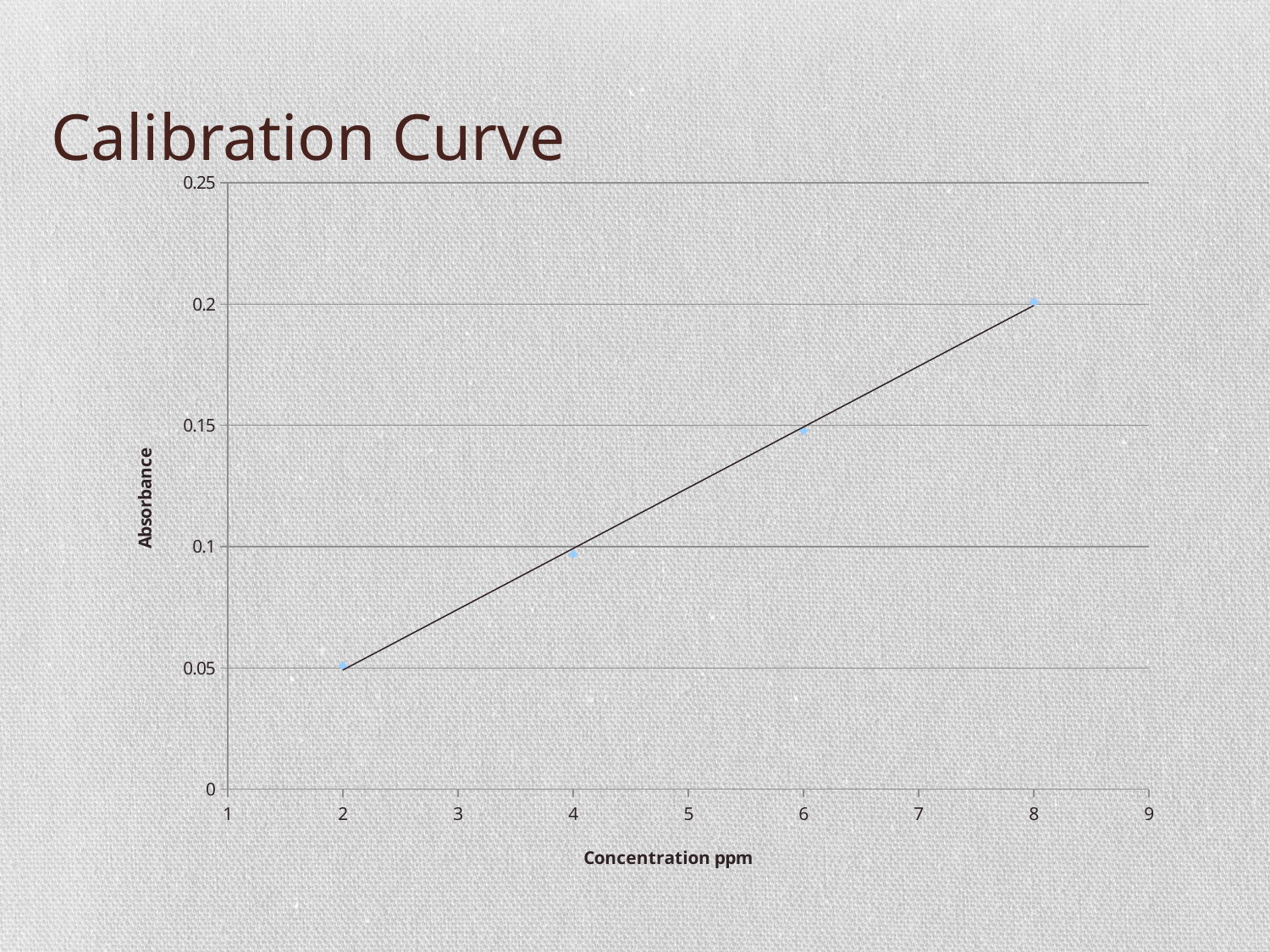
Does absorbance rise or fall as concentration increases along the x axis? rise How many data points are plotted on the chart? 4 At which concentration is the absorbance lowest? 2 What is the title of the chart? Calibration Curve What kind of chart is shown on the slide? scatter chart Is the absorbance at 4 ppm greater or less than 0.05? greater Is the absorbance at 6 ppm greater or less than 0.1? greater At which concentration is the absorbance highest? 8 Which has the larger absorbance, 4 ppm or 6 ppm? 6 ppm What is the label of the x axis? Concentration ppm